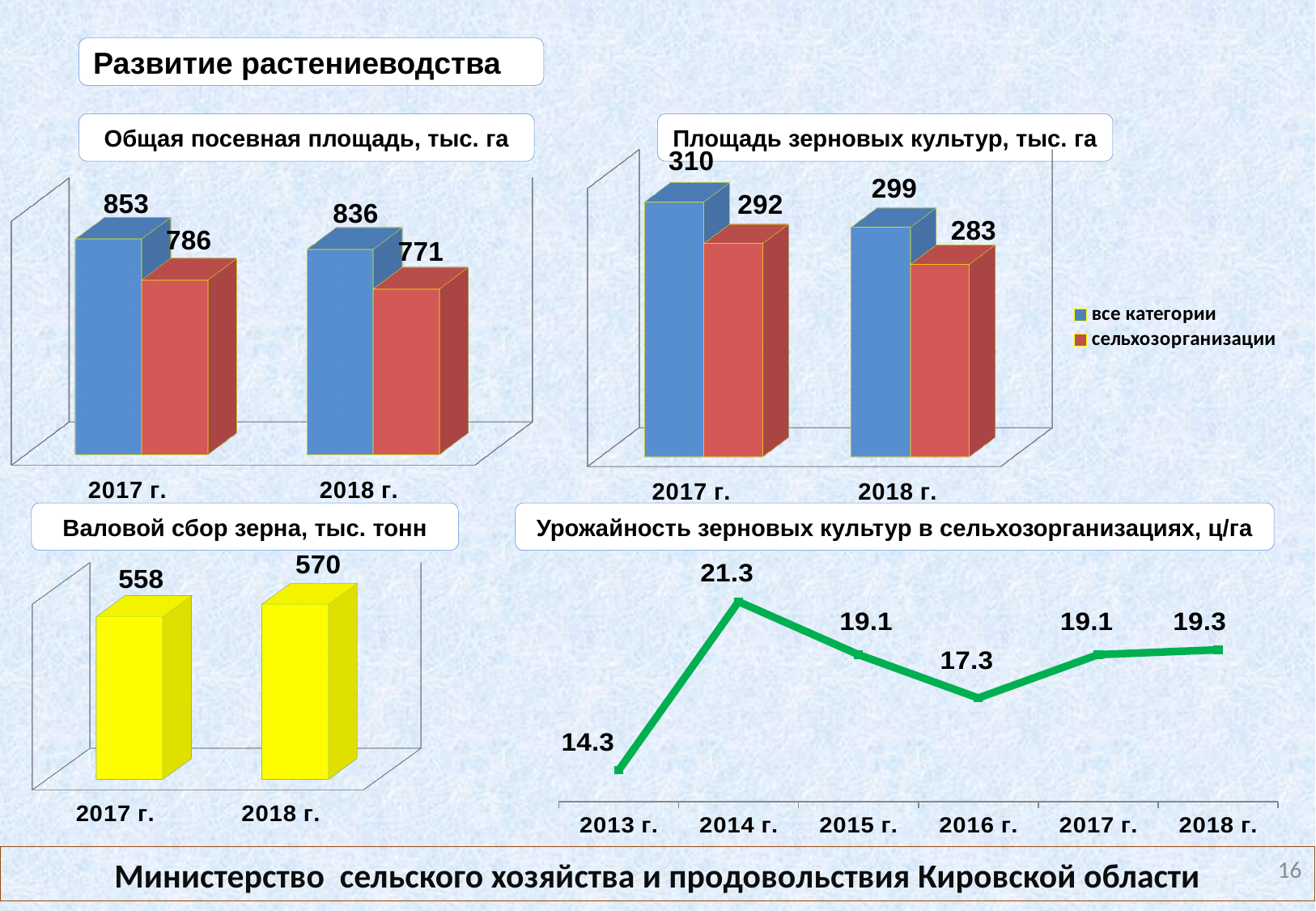
In the chart 'Общая посевная площадь, тыс. га', what is the value for 'все категории' in 2017 г.? 853 In the chart 'Урожайность зерновых культур в сельхозорганизациях, ц/га', which year has the highest value? 2014 г. In the chart 'Валовой сбор зерна, тыс. тонн', which year has the higher value, 2017 г. or 2018 г.? 2018 г. In the chart 'Общая посевная площадь, тыс. га', what is the value for 'сельхозорганизации' in 2018 г.? 771 In the chart 'Площадь зерновых культур, тыс. га', how many series does the legend list? 2 In the chart 'Площадь зерновых культур, тыс. га', what is the value for 'сельхозорганизации' in 2017 г.? 292 In the chart 'Общая посевная площадь, тыс. га', what is the difference between 'все категории' and 'сельхозорганизации' in 2017 г.? 67 In the chart 'Урожайность зерновых культур в сельхозорганизациях, ц/га', which year has the lowest value? 2013 г. In the chart 'Урожайность зерновых культур в сельхозорганизациях, ц/га', how many years are plotted? 6 In the chart 'Валовой сбор зерна, тыс. тонн', what is the value for 2018 г.? 570 In the chart 'Площадь зерновых культур, тыс. га', what is the value for 'все категории' in 2018 г.? 299 What kind of chart is 'Урожайность зерновых культур в сельхозорганизациях, ц/га'? line chart